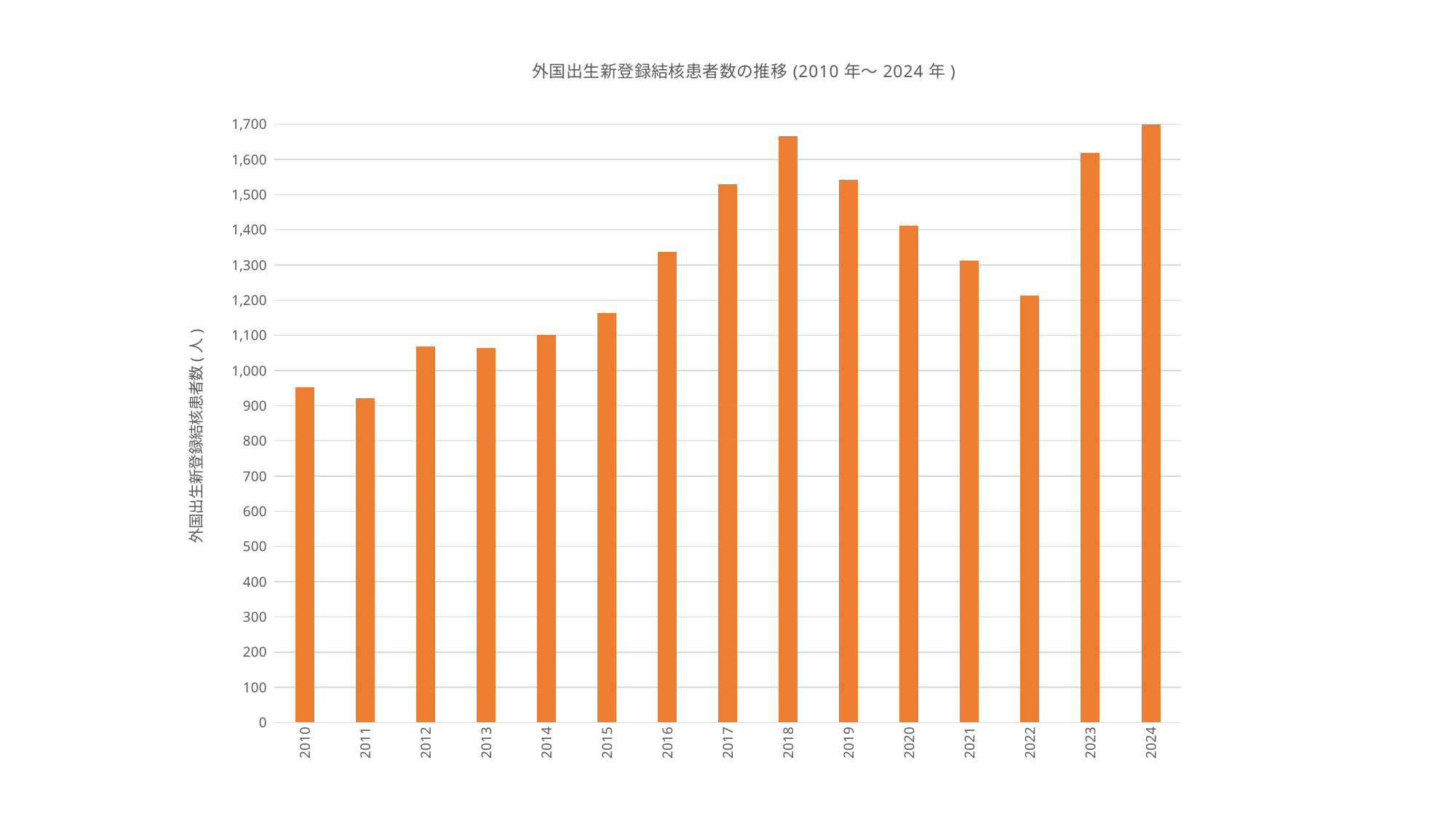
Is the value for 2016 greater or less than 1,300? greater Do the values rise or fall from 2018 to 2022? fall How many years are plotted on the x axis? 15 Which year has the highest number of foreign-born newly registered TB patients? 2024 What kind of chart is shown on the slide? bar chart What is the title of the chart? 外国出生新登録結核患者数の推移 (2010 年～ 2024 年 ) Is the value for 2022 greater or less than 1,100? greater Is the value for 2021 greater or less than 1,400? less Which year has the lowest number of foreign-born newly registered TB patients? 2011 Which is larger, the value for 2018 or the value for 2023? 2018